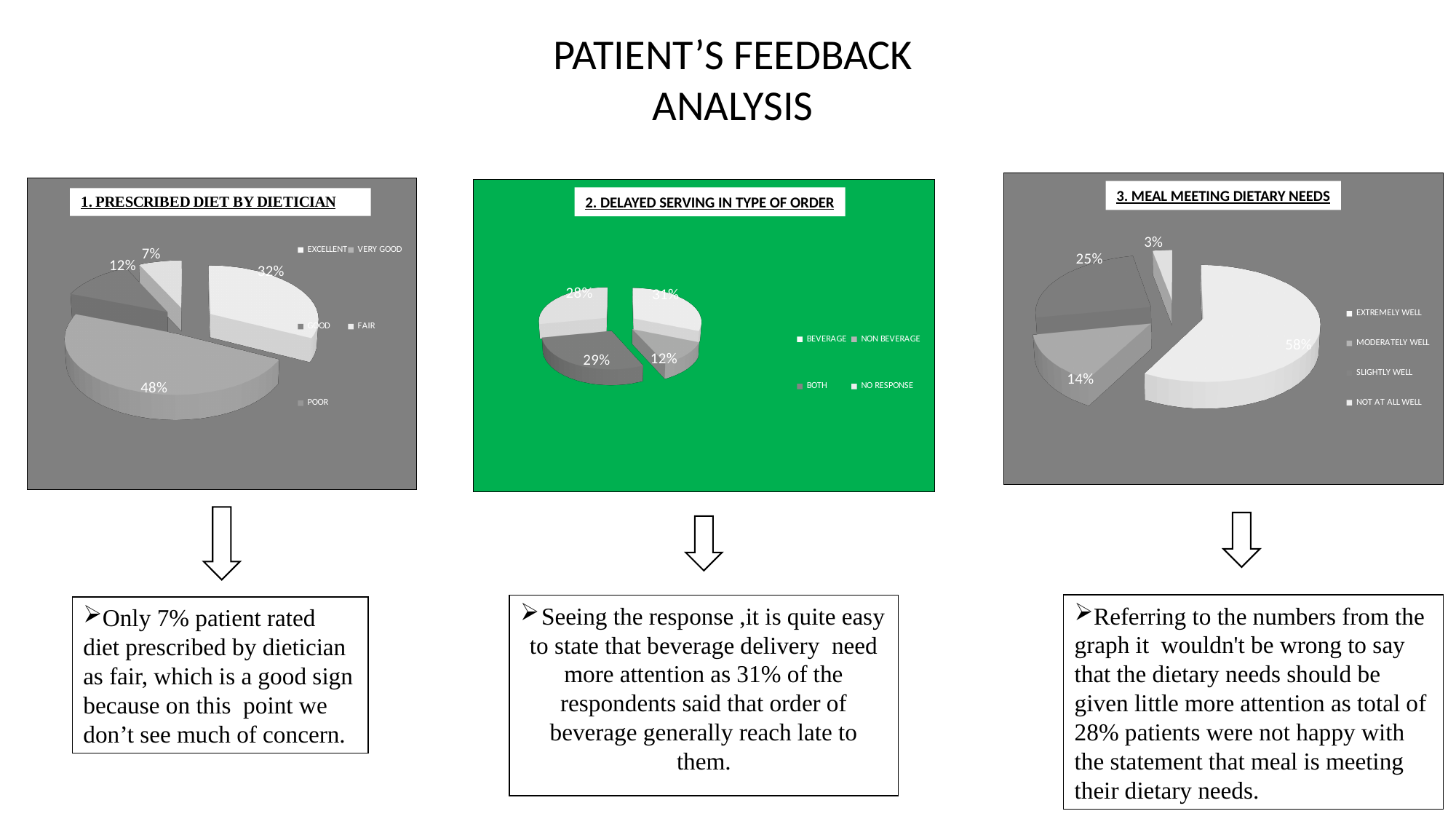
What is the title of the chart with the green background? 2. DELAYED SERVING IN TYPE OF ORDER In the '1. PRESCRIBED DIET BY DIETICIAN' chart, what is the largest percentage shown on a slice? 48% In the '2. DELAYED SERVING IN TYPE OF ORDER' chart, what is the smallest percentage shown on a slice? 12% In the '1. PRESCRIBED DIET BY DIETICIAN' chart, what is the smallest percentage labelled on a slice? 7% In the '2. DELAYED SERVING IN TYPE OF ORDER' chart, what is the difference between the 31% slice and the 12% slice? 19 percentage points How many categories does the legend of the '1. PRESCRIBED DIET BY DIETICIAN' chart list? 5 In the '3. MEAL MEETING DIETARY NEEDS' chart, which is larger: the 25% slice or the 14% slice? The 25% slice In the '3. MEAL MEETING DIETARY NEEDS' chart, what is the largest percentage shown on a slice? 58% How many categories does the legend of the '2. DELAYED SERVING IN TYPE OF ORDER' chart list? 4 In the '3. MEAL MEETING DIETARY NEEDS' chart, what is the smallest percentage shown on a slice? 3% What kind of chart is used in the '1. PRESCRIBED DIET BY DIETICIAN' chart? Pie chart In the '2. DELAYED SERVING IN TYPE OF ORDER' chart, what percentage of respondents said beverage orders were delayed? 31%